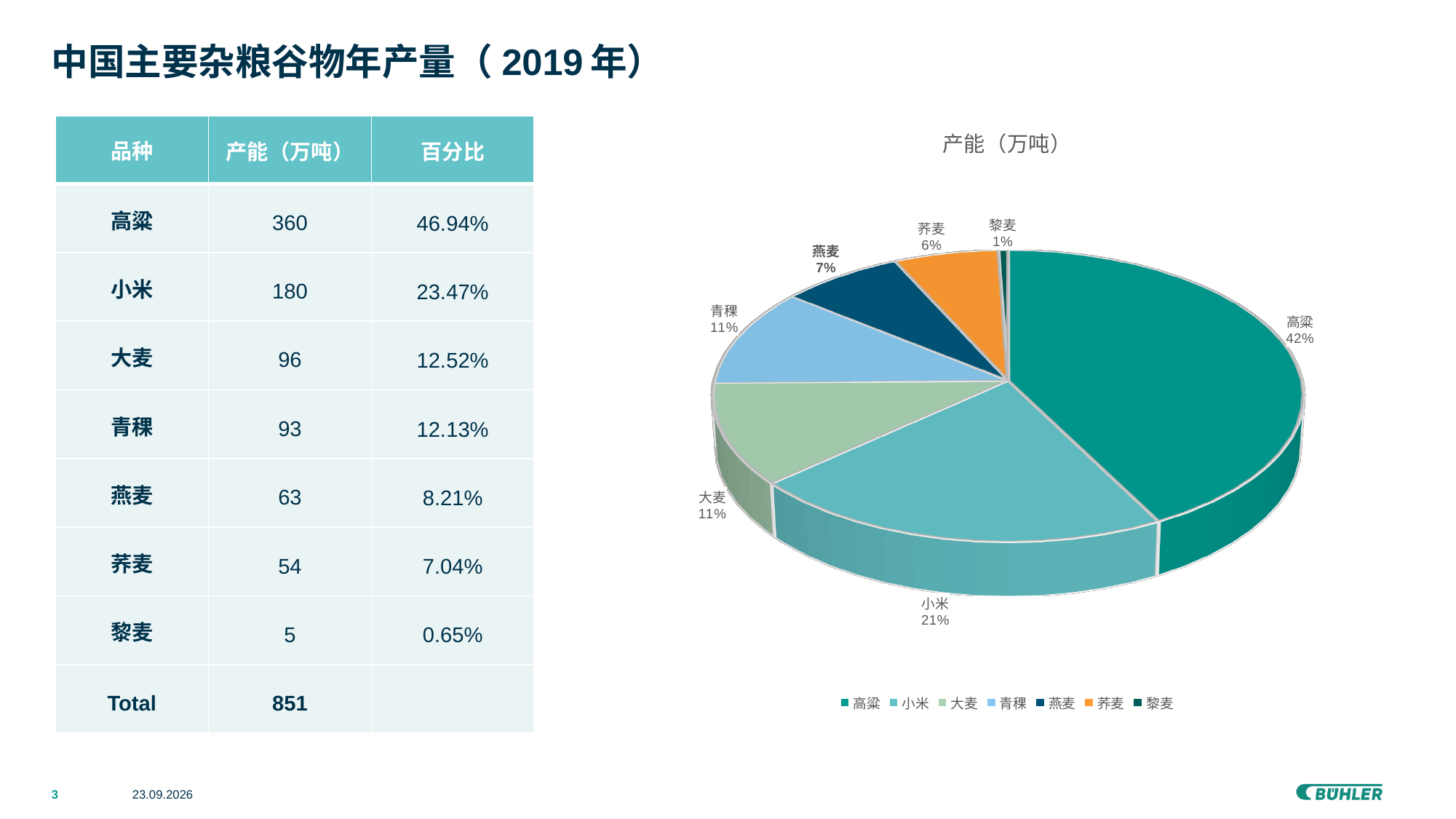
What share of the pie does 小米 account for? 21% Which category has the smallest slice in the pie chart? 黎麦 Which slice is larger in the pie chart, 小米 or 燕麦? 小米 What share of the pie does 高粱 account for? 42% Which category has the largest slice in the pie chart? 高粱 What percentage is shown for 燕麦 in the pie chart? 7% What is the title of the pie chart? 产能（万吨） How many entries does the pie chart's legend list? 7 What percentage is shown for 荞麦 in the pie chart? 6% What is the difference in percentage points between the 高粱 slice and the 小米 slice? 21% How many slices does the pie chart have? 7 What kind of chart is shown on the slide? pie chart